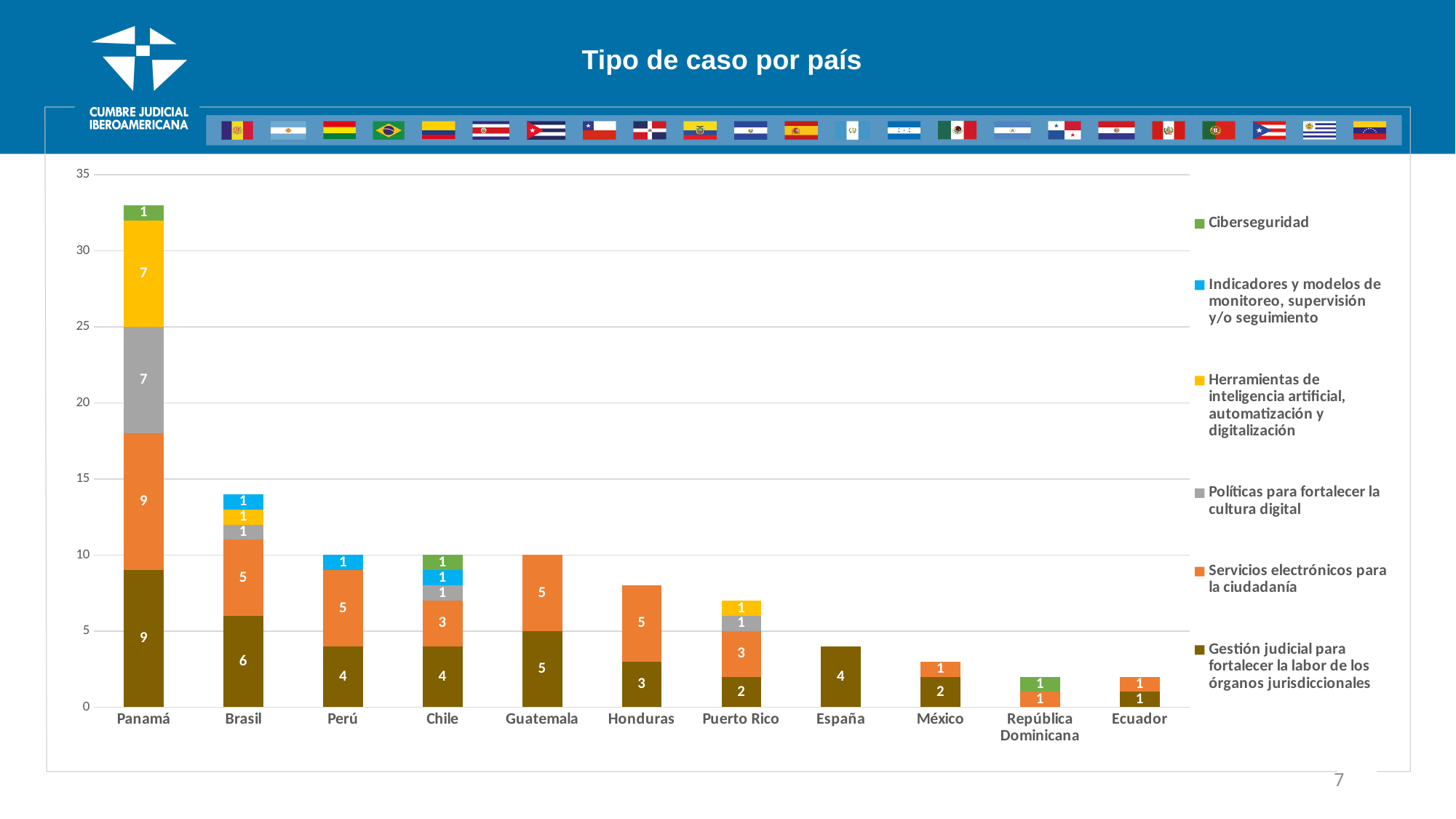
What kind of chart is shown on the slide? Stacked bar chart What is the value of 'Servicios electrónicos para la ciudadanía' for Panamá? 9 What is the value of 'Gestión judicial para fortalecer la labor de los órganos jurisdiccionales' for Brasil? 6 What is the total of the stacked bar for Brasil? 14 How many series does the legend list? 6 What is the total of the stacked bar for Puerto Rico? 7 Which country has the highest total stacked bar? Panamá What is the difference between the 'Servicios electrónicos para la ciudadanía' values for Honduras and México? 4 How many countries are shown on the x axis of the chart? 11 What is the value of 'Herramientas de inteligencia artificial, automatización y digitalización' for Panamá? 7 Which is larger: the 'Gestión judicial' value for Guatemala or for Honduras? Guatemala What is the title of the chart? Tipo de caso por país